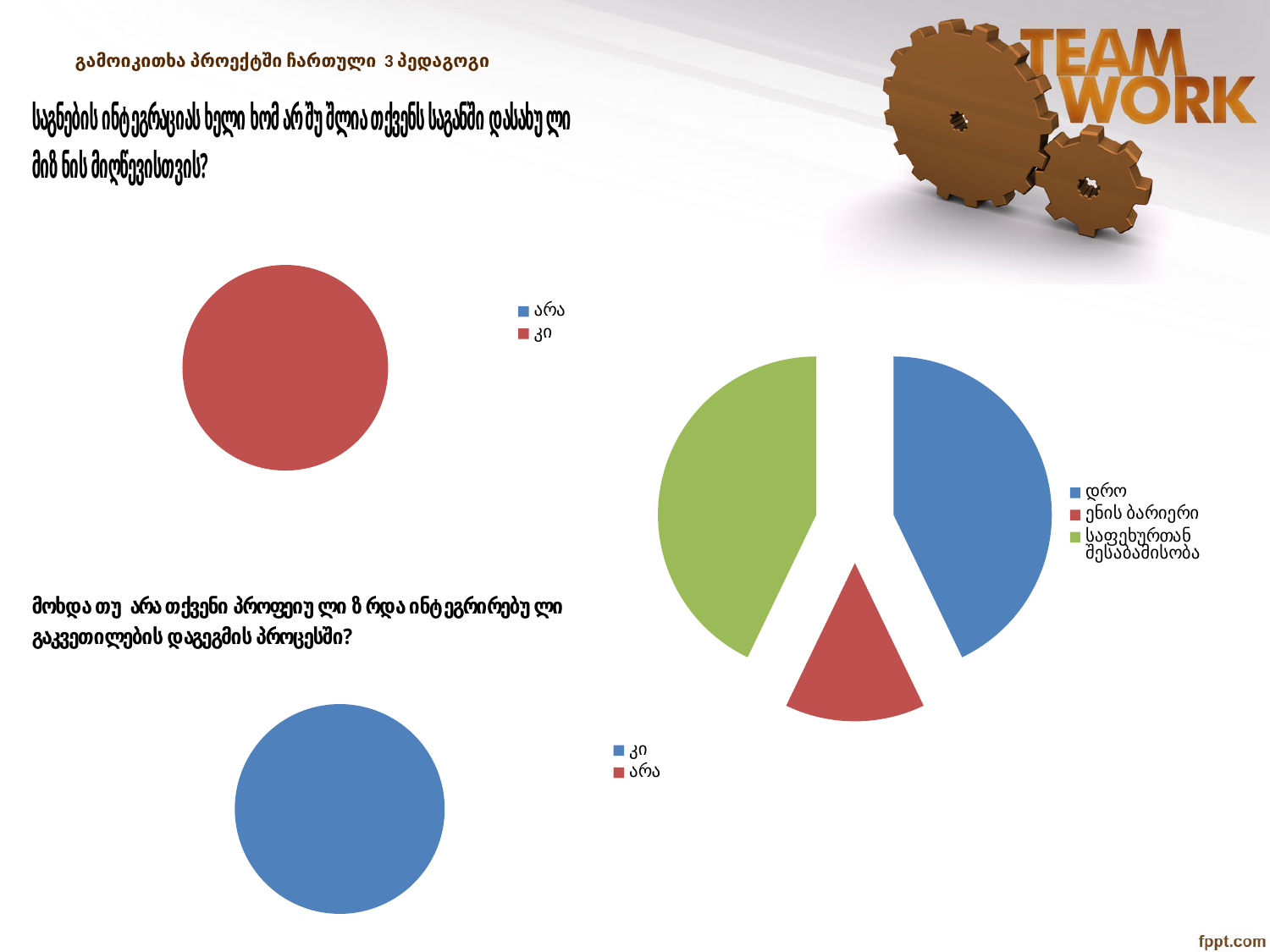
How many entries does the legend of the top-left pie chart list? 2 What kind of chart is the chart on the right side of the slide? pie chart In the right-hand pie chart, which slice is larger: დრო or ენის ბარიერი? დრო In the right-hand pie chart, what colour is the slice for დრო? blue How many entries does the legend of the bottom-left pie chart list? 2 In the bottom-left pie chart, which category fills the entire pie? კი In the top-left pie chart, which category fills the entire pie? კი How many entries does the legend of the right-hand pie chart list? 3 How many pie charts are shown on the slide? 3 What kind of chart is the top-left chart on the slide? pie chart In the right-hand pie chart, which slice is larger: ენის ბარიერი or საფეხურთან შესაბამისობა? საფეხურთან შესაბამისობა In the right-hand pie chart, which category has the smallest slice? ენის ბარიერი